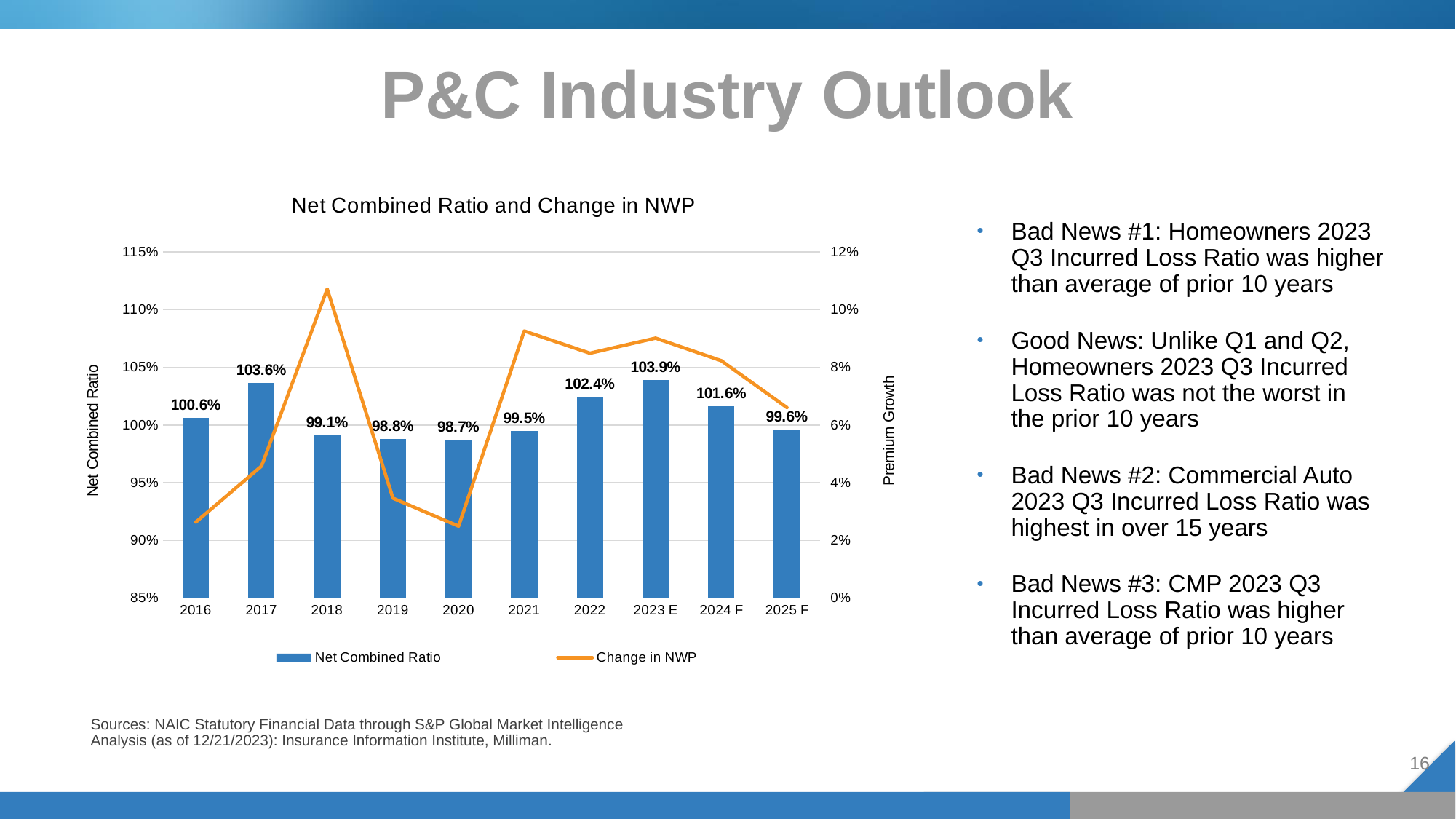
Is the Change in NWP for 2018 greater or less than 10%? greater Is the Change in NWP for 2020 greater or less than 4%? less What is the Net Combined Ratio for 2022? 102.4% What is the Net Combined Ratio for 2024 F? 101.6% What is the difference between the Net Combined Ratio in 2017 and in 2016? 3.0% What kind of chart is shown on the slide? Combination bar and line chart Which is larger, the Net Combined Ratio for 2021 or for 2025 F? 2025 F Which year has the highest Net Combined Ratio? 2023 E How many series does the chart legend list? 2 How many years are shown on the x axis of the chart? 10 Which year has the lowest Net Combined Ratio? 2020 What is the title of the chart? Net Combined Ratio and Change in NWP